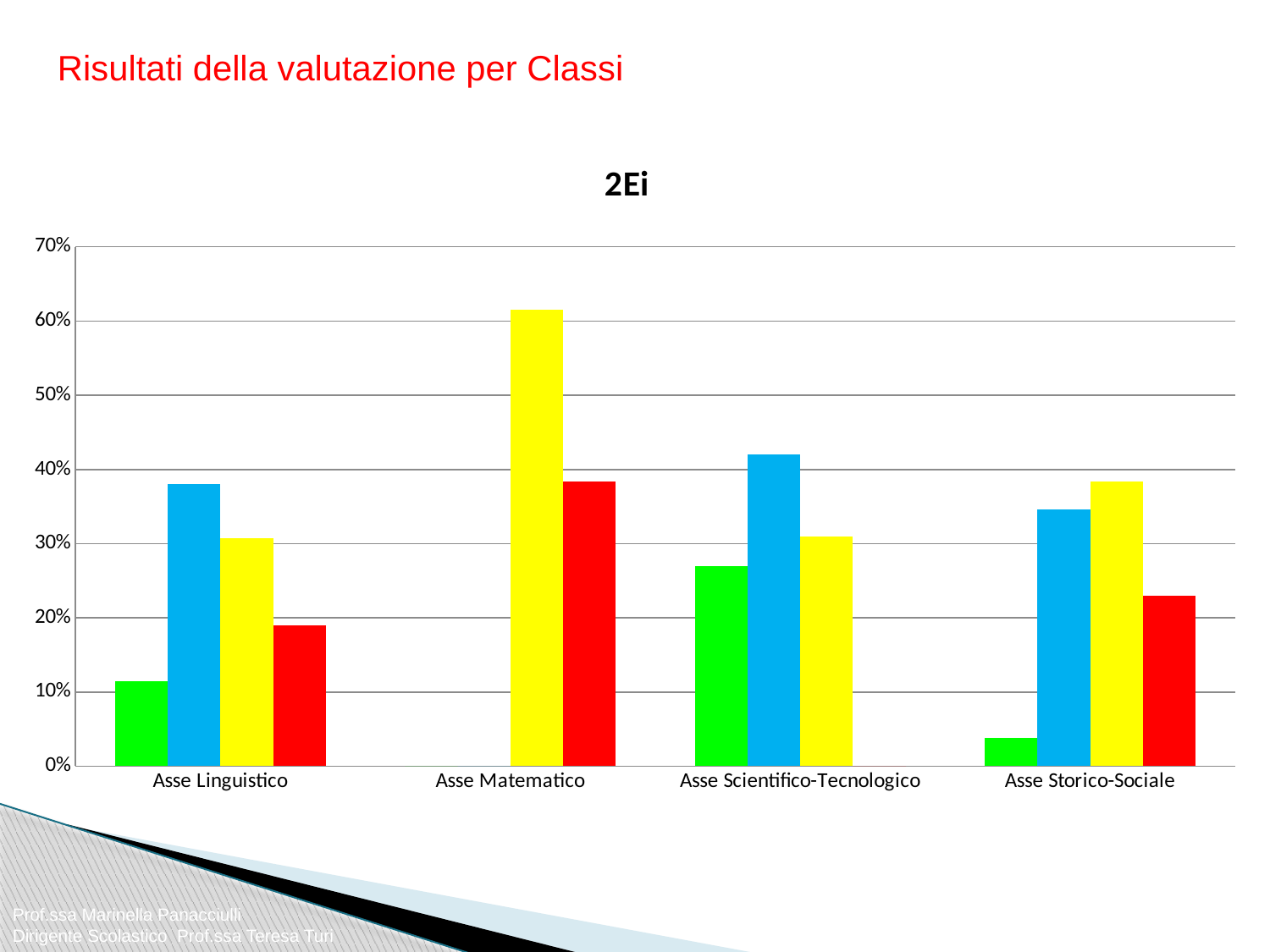
Is the green bar for Asse Storico-Sociale greater or less than 10%? less Is the red bar for Asse Storico-Sociale greater or less than 30%? less In the Asse Matematico category, which bar is taller, the yellow one or the red one? the yellow one Is the green bar for Asse Linguistico greater or less than 20%? less What is the title of the chart? 2Ei What kind of chart is shown on the slide? bar chart How many categories are shown on the x axis of the chart? 4 In the Asse Linguistico category, which bar is taller, the blue one or the green one? the blue one Which category contains the tallest bar in the chart? Asse Matematico How many bars are plotted for the Asse Matematico category? 2